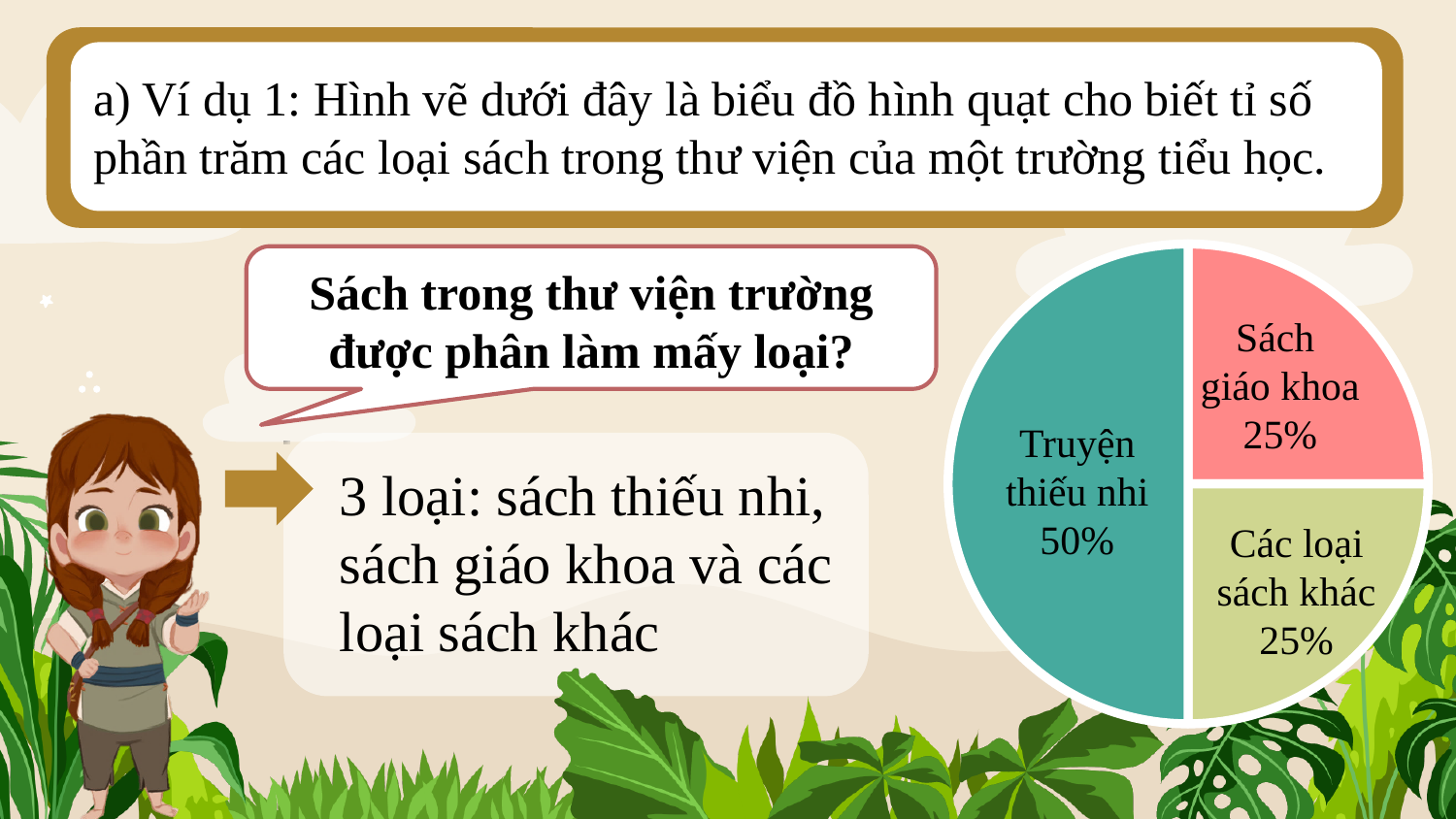
What kind of chart is shown on the slide? pie chart Which is larger in the pie chart: "Truyện thiếu nhi" or "Các loại sách khác"? Truyện thiếu nhi What colour is the "Sách giáo khoa" slice of the pie chart? pink What is the difference in percentage points between "Truyện thiếu nhi" and "Sách giáo khoa"? 25 What is the combined share of "Sách giáo khoa" and "Các loại sách khác"? 50% Which category has the largest share of the pie chart? Truyện thiếu nhi What percentage of the pie chart is "Truyện thiếu nhi"? 50% What share of the pie does "Truyện thiếu nhi" take? 50% What colour is the "Truyện thiếu nhi" slice of the pie chart? teal What percentage of the pie chart is "Sách giáo khoa"? 25% What percentage of the pie chart is "Các loại sách khác"? 25% How many slices does the pie chart have? 3